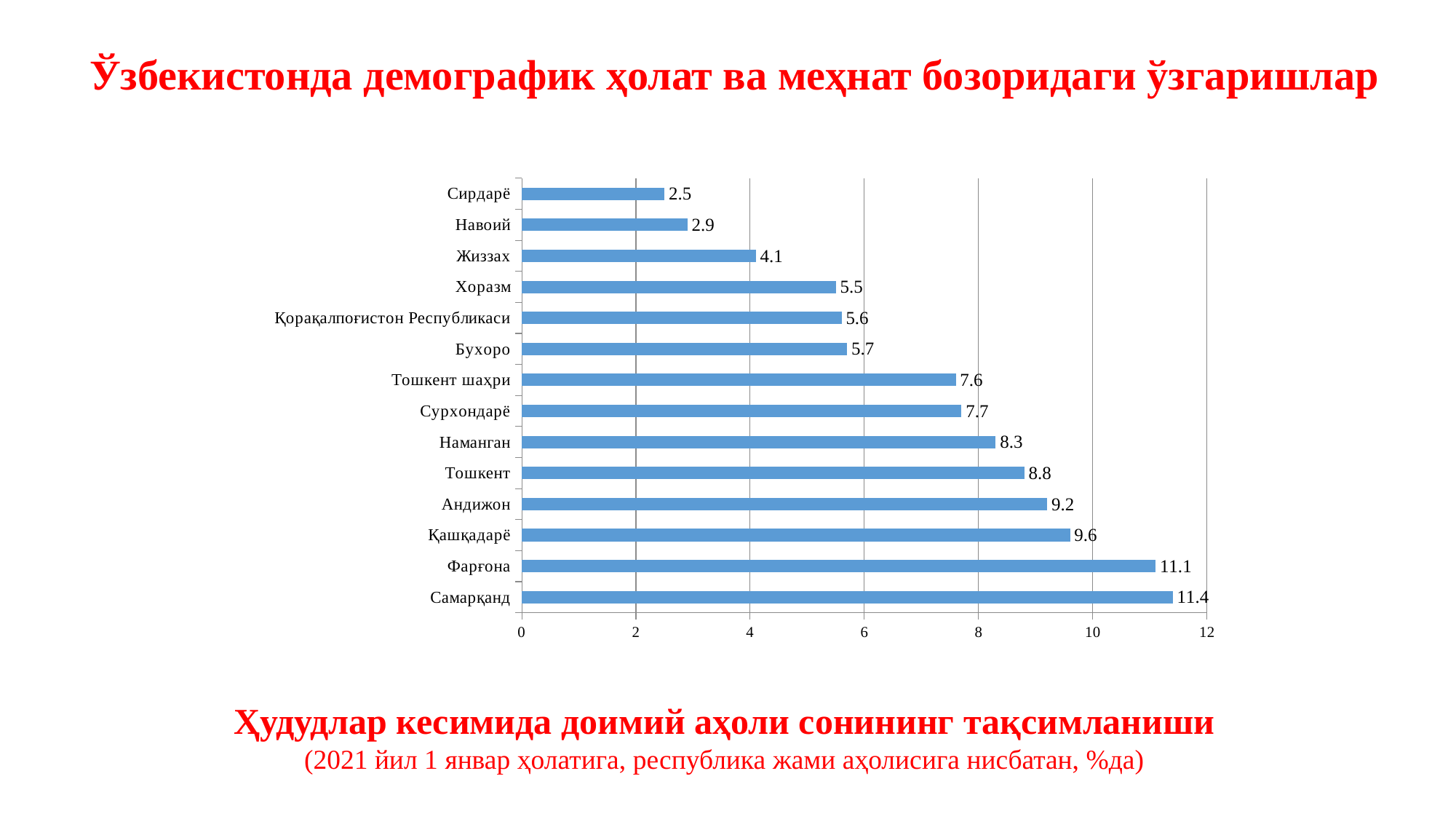
What is the value for Самарқанд? 11.4 What kind of chart is shown on the slide? bar chart Is the value for Хоразм greater or less than 6? less What is the title shown below the chart? Ҳудудлар кесимида доимий аҳоли сонининг тақсимланиши What is the value for Қорақалпоғистон Республикаси? 5.6 Which region has the highest value? Самарқанд Which is larger, the value for Қашқадарё or the value for Тошкент? Қашқадарё What is the value for Жиззах? 4.1 Which region has the lowest value? Сирдарё What is the difference between the values for Фарғона and Сирдарё? 8.6 What is the difference between the values for Андижон and Наманган? 0.9 How many regions are shown in the chart? 14